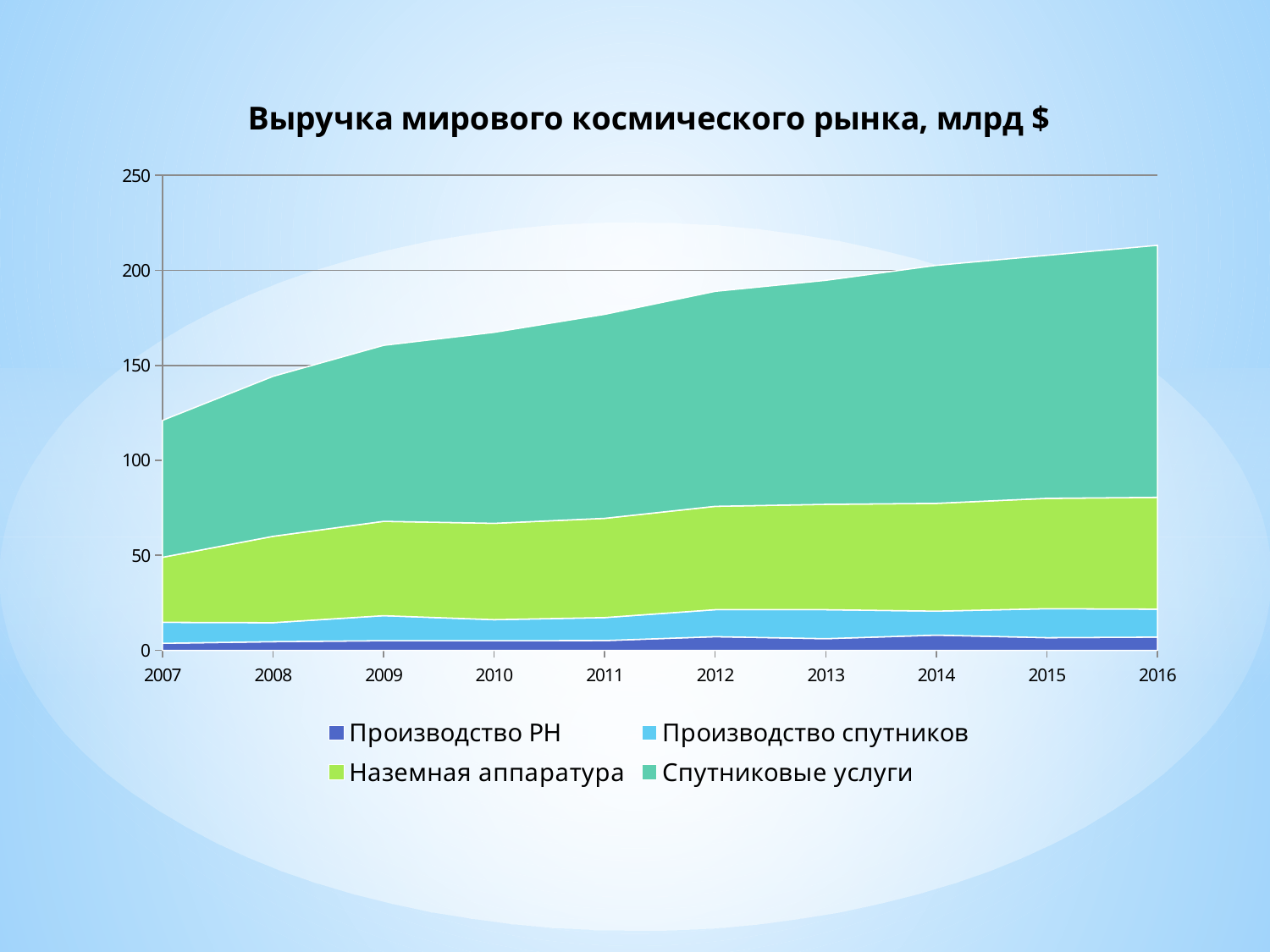
Which series contributes the largest share of revenue across the years? Спутниковые услуги Does the total revenue rise or fall from 2007 to 2016? Rises What kind of chart is shown on the slide? Stacked area chart Which series is listed first in the legend? Производство РН Is the total value for 2007 greater or less than 150? less How many years are plotted along the x axis? 10 Is the total value for 2012 greater or less than 150? greater Is the total value for 2007 greater or less than 100? greater What is the title of the chart? Выручка мирового космического рынка, млрд $ Which series contributes the smallest share of revenue across the years? Производство РН How many series does the legend list? 4